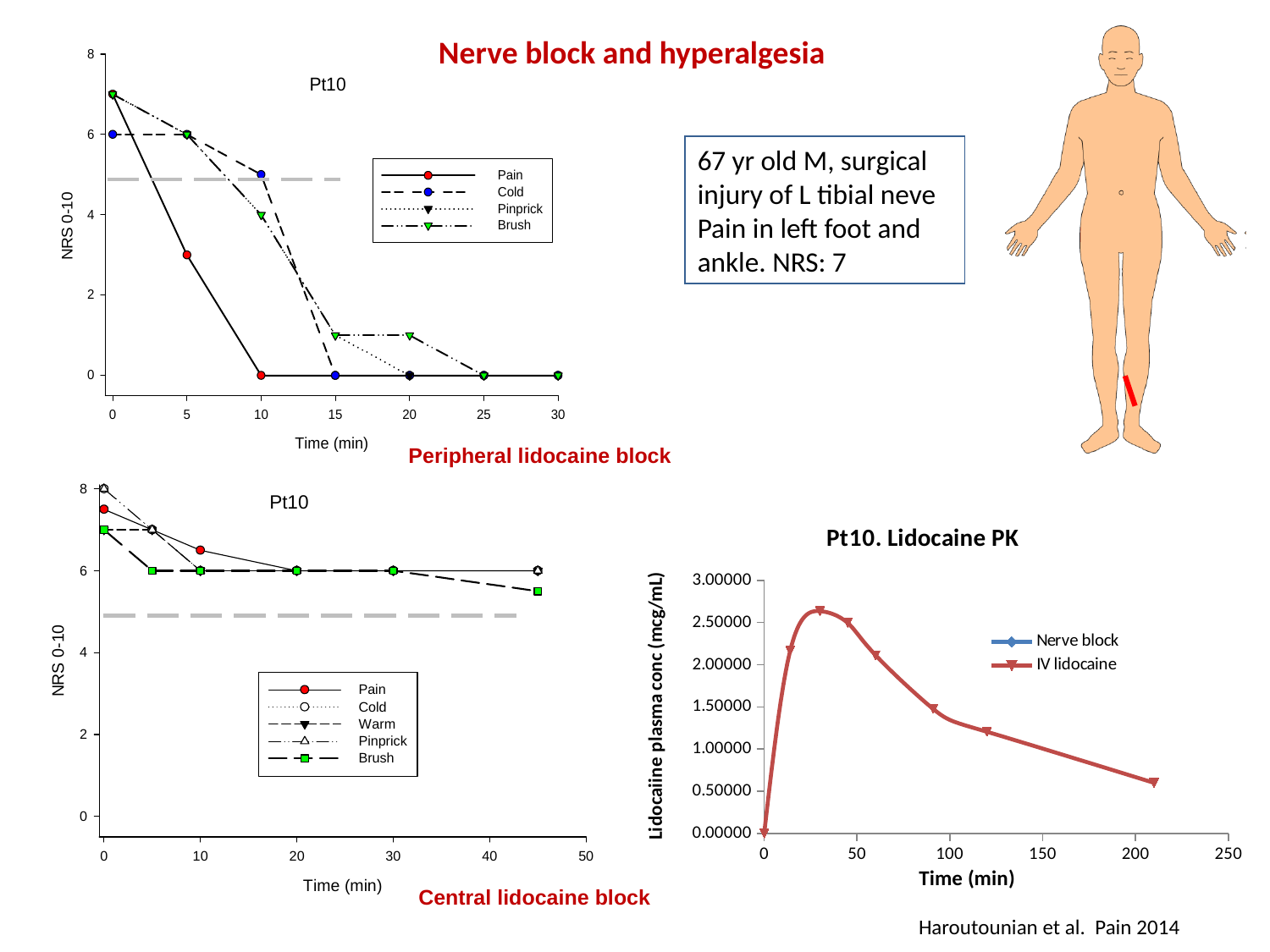
In the 'Peripheral lidocaine block' chart, at 5 min is the Cold value or the Pain value larger? Cold How many series does the legend of the 'Pt10. Lidocaine PK' chart list? 2 In the 'Peripheral lidocaine block' chart, what is the Cold NRS value at 0 min? 6 How many series does the legend of the 'Central lidocaine block' chart list? 5 How many series does the legend of the 'Peripheral lidocaine block' chart list? 4 In the 'Pt10. Lidocaine PK' chart, is the peak IV lidocaine plasma concentration greater or less than 2.50000? greater In the 'Central lidocaine block' chart, what is the Brush NRS value at 5 min? 6 What kind of chart is the 'Pt10. Lidocaine PK' chart? line chart In the 'Pt10. Lidocaine PK' chart, does the IV lidocaine concentration rise or fall between 30 min and 210 min? fall In the 'Peripheral lidocaine block' chart, what is the Pain NRS value at 10 min? 0 In the 'Peripheral lidocaine block' chart, which series has the highest NRS value at 10 min? Cold In the 'Pt10. Lidocaine PK' chart, is the IV lidocaine plasma concentration at about 210 min greater or less than 1.00000? less